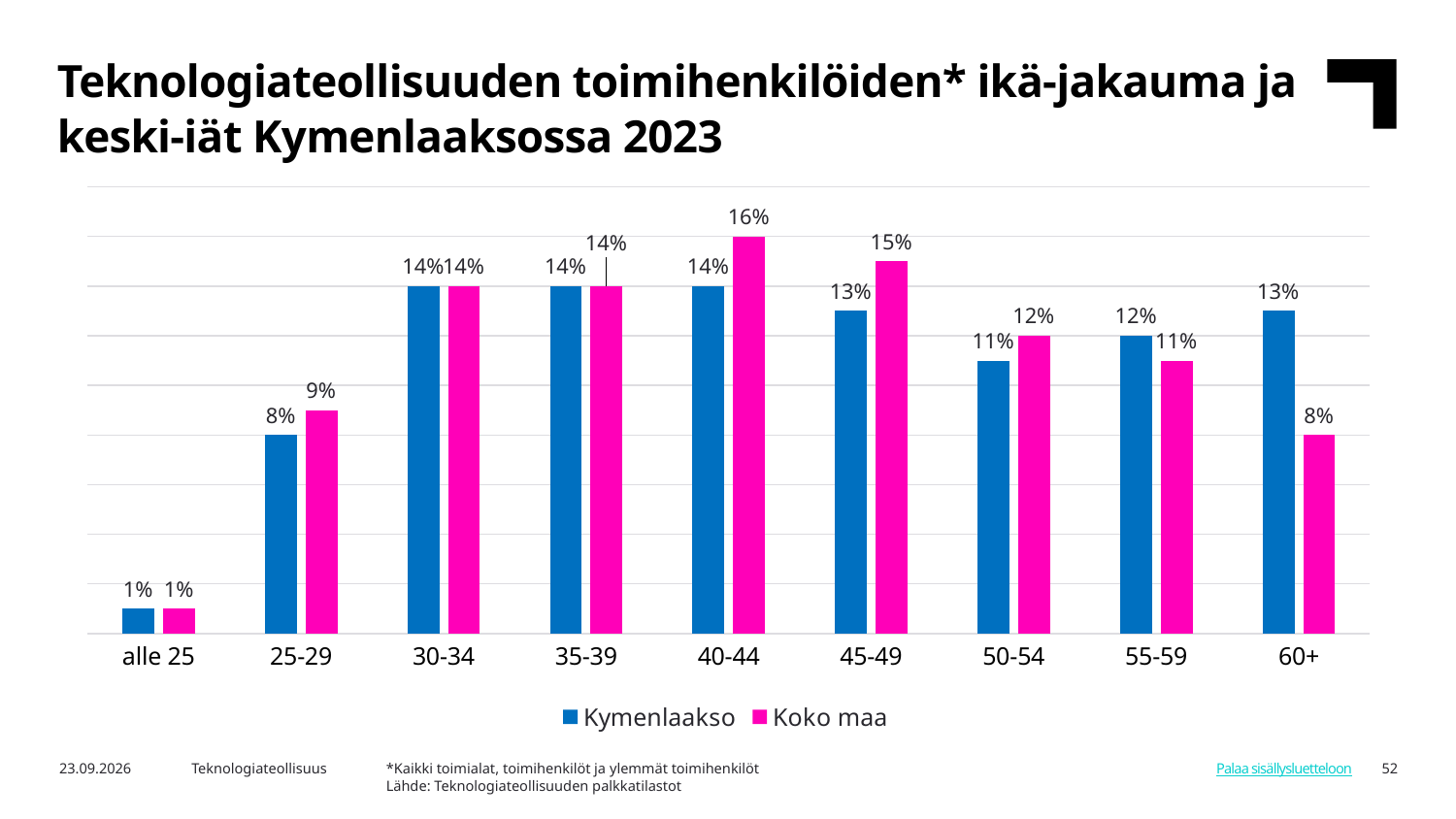
For the 55-59 age group, which series has the larger value, Kymenlaakso or Koko maa? Kymenlaakso What is the Kymenlaakso value for the 25-29 age group? 8% What is the Koko maa value for the 40-44 age group? 16% How many age groups are shown on the x axis? 9 What is the difference between the Koko maa and Kymenlaakso values for the 60+ age group? 5% For the 45-49 age group, which series has the larger value, Kymenlaakso or Koko maa? Koko maa Which age group has the highest Koko maa value? 40-44 How many series does the legend list? 2 What is the Kymenlaakso value for the 60+ age group? 13% Which age group has the lowest Kymenlaakso value? alle 25 What kind of chart is shown on the slide? Bar chart Which colour represents the Koko maa series? Pink